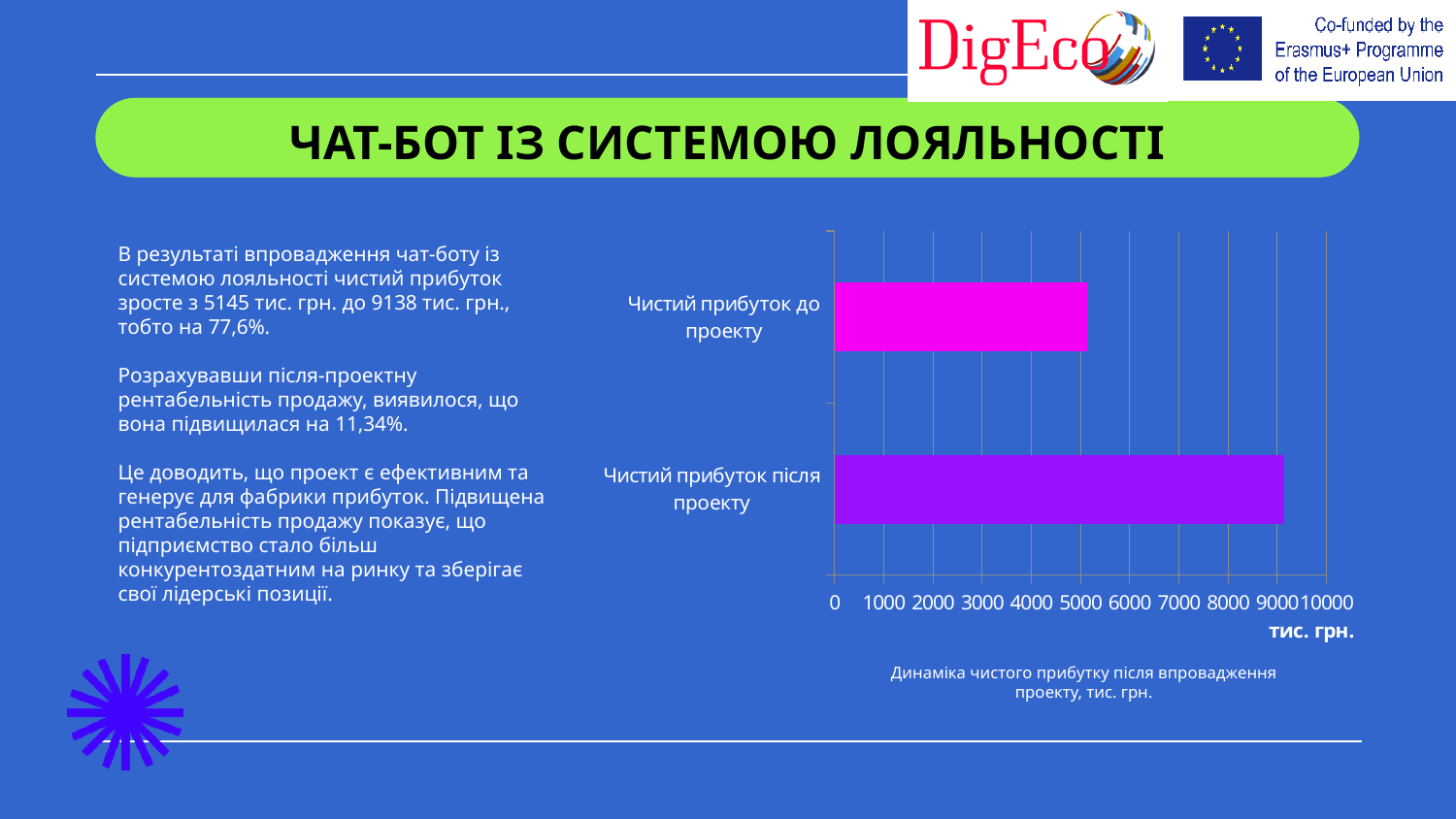
What kind of chart is shown on the slide? bar chart Which category has the lowest value in the chart? Чистий прибуток до проекту Is the value for "Чистий прибуток після проекту" greater or less than 10000? less Which category has the highest value in the chart? Чистий прибуток після проекту How many categories does the chart show? 2 Is the value for "Чистий прибуток до проекту" greater or less than 4000? greater Is the value for "Чистий прибуток до проекту" greater or less than 6000? less What is the net profit after the project ("Чистий прибуток після проекту") according to the slide? 9138 тис. грн. What is the net profit before the project ("Чистий прибуток до проекту") according to the slide? 5145 тис. грн. Which category has the higher value: "Чистий прибуток до проекту" or "Чистий прибуток після проекту"? Чистий прибуток після проекту What unit is shown on the horizontal axis of the chart? тис. грн.